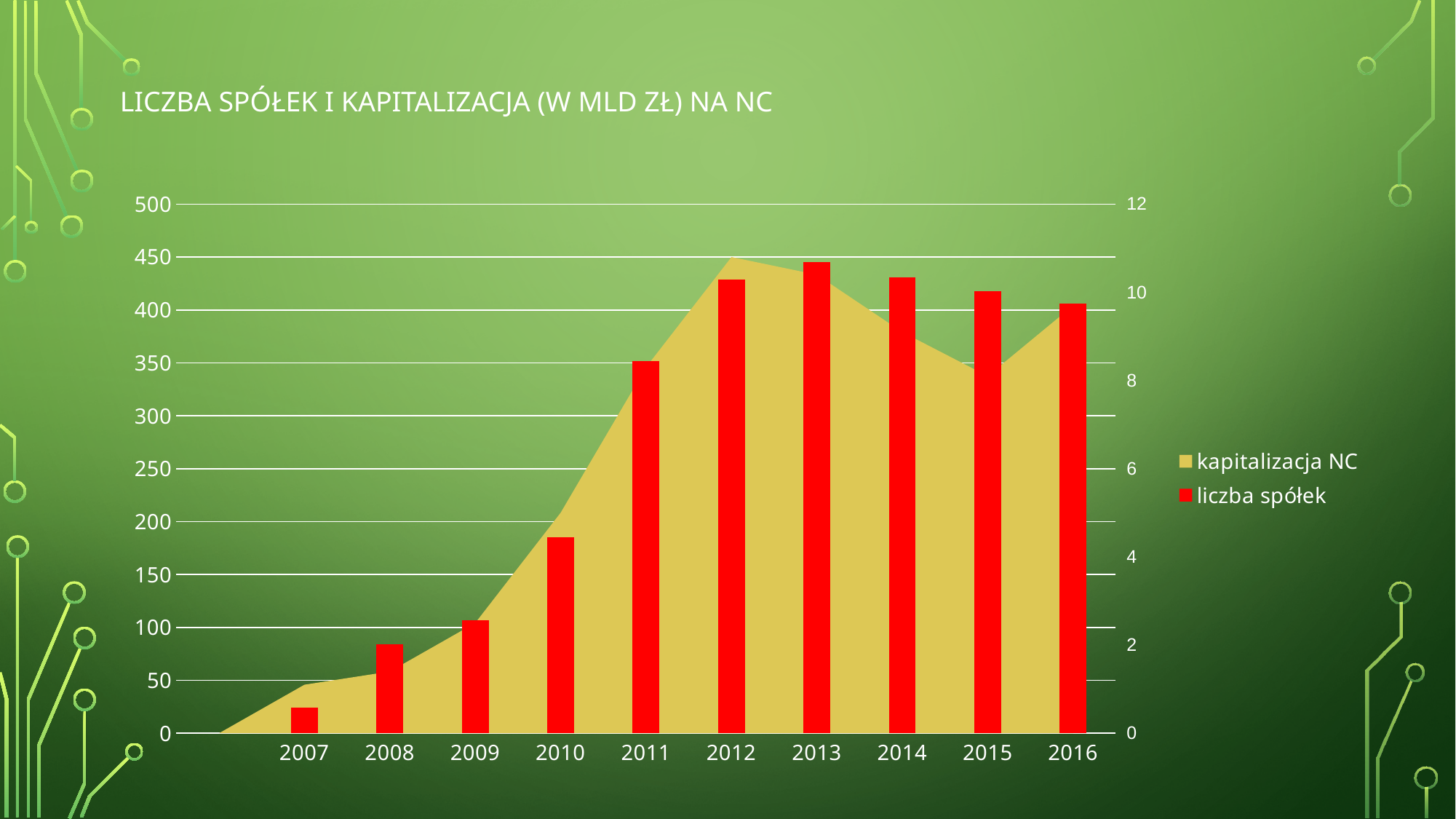
Which year has the tallest 'liczba spółek' bar? 2013 Which year has the shortest 'liczba spółek' bar? 2007 Do the 'liczba spółek' bars rise or fall from 2007 to 2012? rise What is the title of the chart? LICZBA SPÓŁEK I KAPITALIZACJA (W MLD ZŁ) NA NC How many series does the legend list? 2 In which year does the 'kapitalizacja NC' area reach its peak? 2012 Which series is drawn in red? liczba spółek What kind of chart is used for the 'liczba spółek' series? Bar chart How many years are shown on the x axis? 10